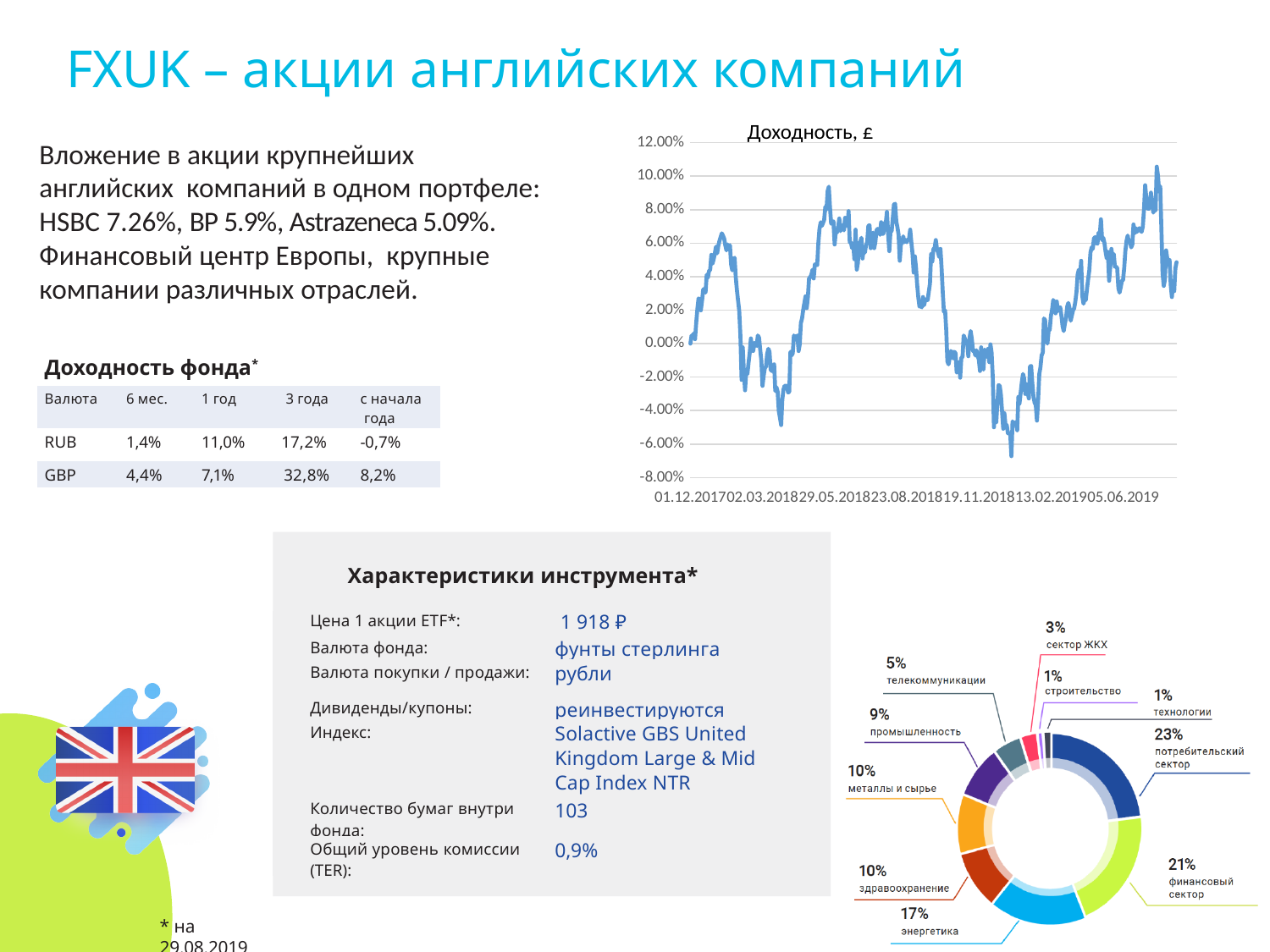
In the sector breakdown chart at the bottom right, what share does "телекоммуникации" have? 5% What kind of chart is the sector breakdown chart at the bottom right of the slide? pie (donut) chart In the sector breakdown chart at the bottom right, what is the difference in percentage points between "финансовый сектор" and "энергетика"? 4 percentage points In the sector breakdown chart at the bottom right, which has the larger share: "здравоохранение" or "промышленность"? здравоохранение In the sector breakdown chart at the bottom right, which sector has the largest share? потребительский сектор In the sector breakdown chart at the bottom right, what share does "потребительский сектор" have? 23% In the sector breakdown chart at the bottom right, what share does "энергетика" have? 17% What is the title of the line chart on the slide? Доходность, £ How many sectors are shown in the sector breakdown chart at the bottom right? 10 What kind of chart is the chart titled "Доходность, £"? line chart In the chart titled "Доходность, £", is the highest point of the line greater or less than 8.00%? greater In the chart titled "Доходность, £", is the lowest point of the line greater or less than -4.00%? less